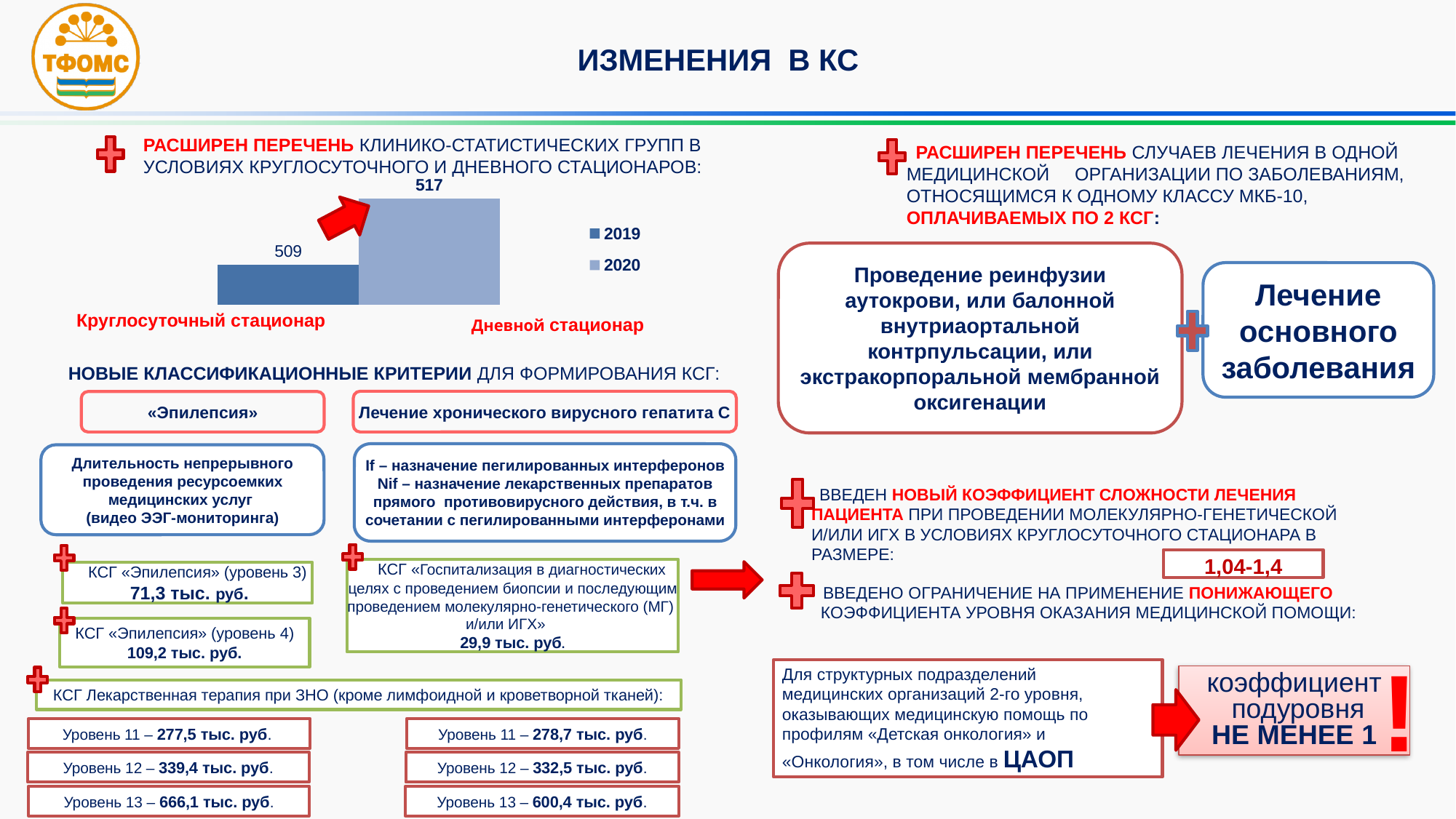
Which series has the lowest value in the chart? 2019 How many series does the chart legend list? 2 What are the two entries listed in the chart legend? 2019 and 2020 Which series has the highest value in the chart? 2020 What is the difference between the 2020 value and the 2019 value in the chart? 8 What is the value shown for 2020 in the chart? 517 How many bars are plotted in the chart? 2 What is the value shown for 2019 in the chart? 509 What type of chart is shown on the slide? bar chart Do the values in the chart rise or fall from 2019 to 2020? rise Which bar in the chart is drawn in the darker blue colour, 2019 or 2020? 2019 Which series has the higher value in the chart, 2019 or 2020? 2020